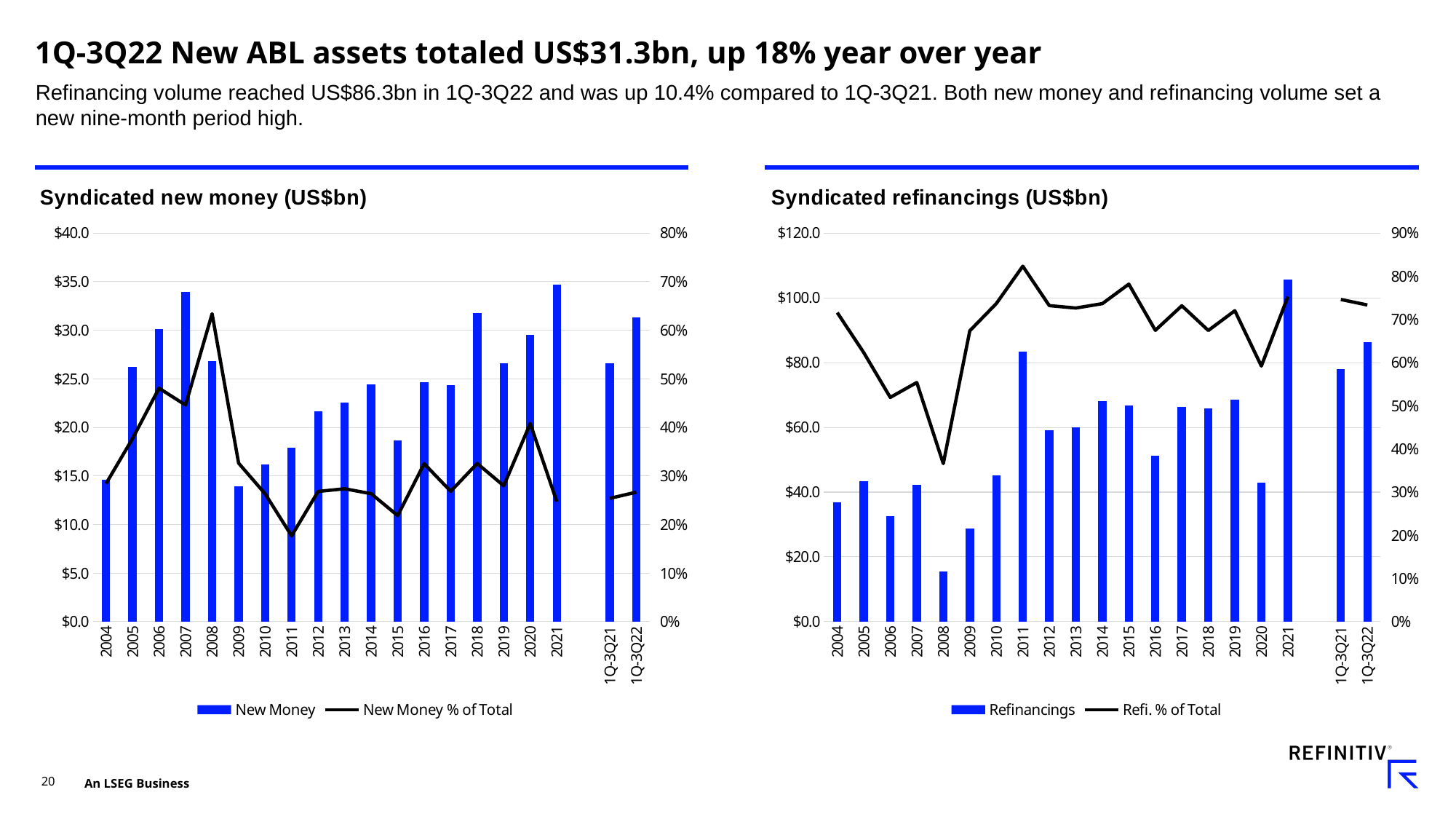
On the Syndicated new money chart, is the New Money value for 2007 greater or less than $30.0? greater On the Syndicated refinancings chart, which category has the lowest Refinancings bar? 2008 On the Syndicated new money chart, which has the larger New Money value, 2005 or 2006? 2006 On the Syndicated new money chart, which year has the highest New Money % of Total? 2008 On the Syndicated new money chart, how many series does the legend list? 2 On the Syndicated new money chart, which year has the lowest New Money % of Total? 2011 On the Syndicated new money chart, is the New Money value for 2011 greater or less than $20.0? less What kind of chart is the Syndicated refinancings chart? Bar chart with a line On the Syndicated refinancings chart, do the Refinancings bars rise or fall from 2008 to 2011? rise On the Syndicated refinancings chart, how many categories are shown on the x axis? 20 On the Syndicated refinancings chart, which category has the highest Refinancings bar? 2021 On the Syndicated refinancings chart, is the Refinancings value for 1Q-3Q22 greater or less than $80.0? greater